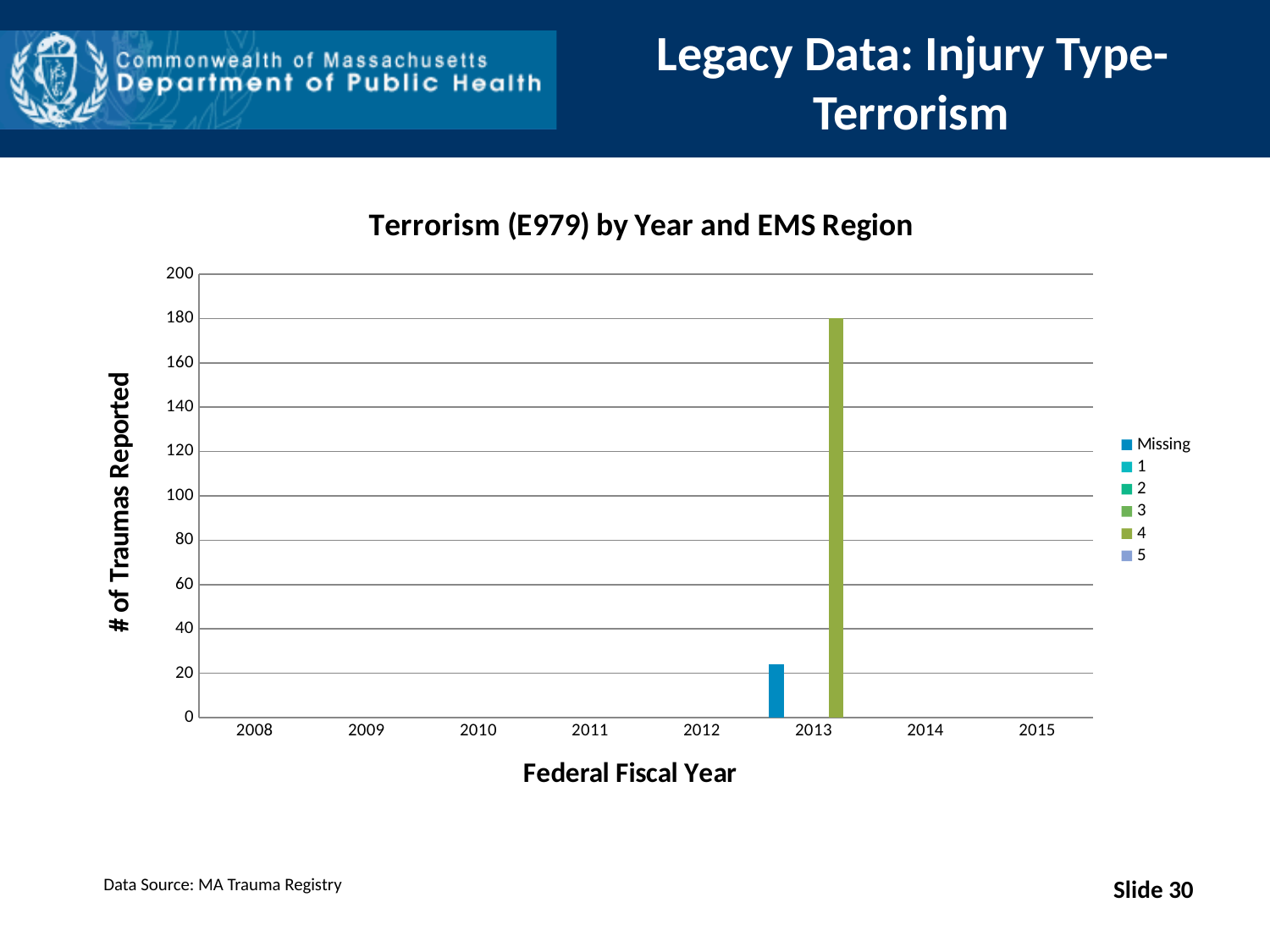
Which fiscal year has the tallest bar? 2013 Is the value for EMS Region 4 in 2013 greater or less than 160? greater What is the title of the chart? Terrorism (E979) by Year and EMS Region How many series does the legend list? 6 Is the value for EMS Region 4 in 2013 greater or less than 200? less How many fiscal years are shown on the x axis? 8 In 2013, which is larger: the Missing series or EMS Region 4? EMS Region 4 What is the label of the x axis? Federal Fiscal Year Which legend series has the tallest bar in the chart? 4 What kind of chart is shown on the slide? bar chart Is the value for the Missing series in 2013 greater or less than 40? less